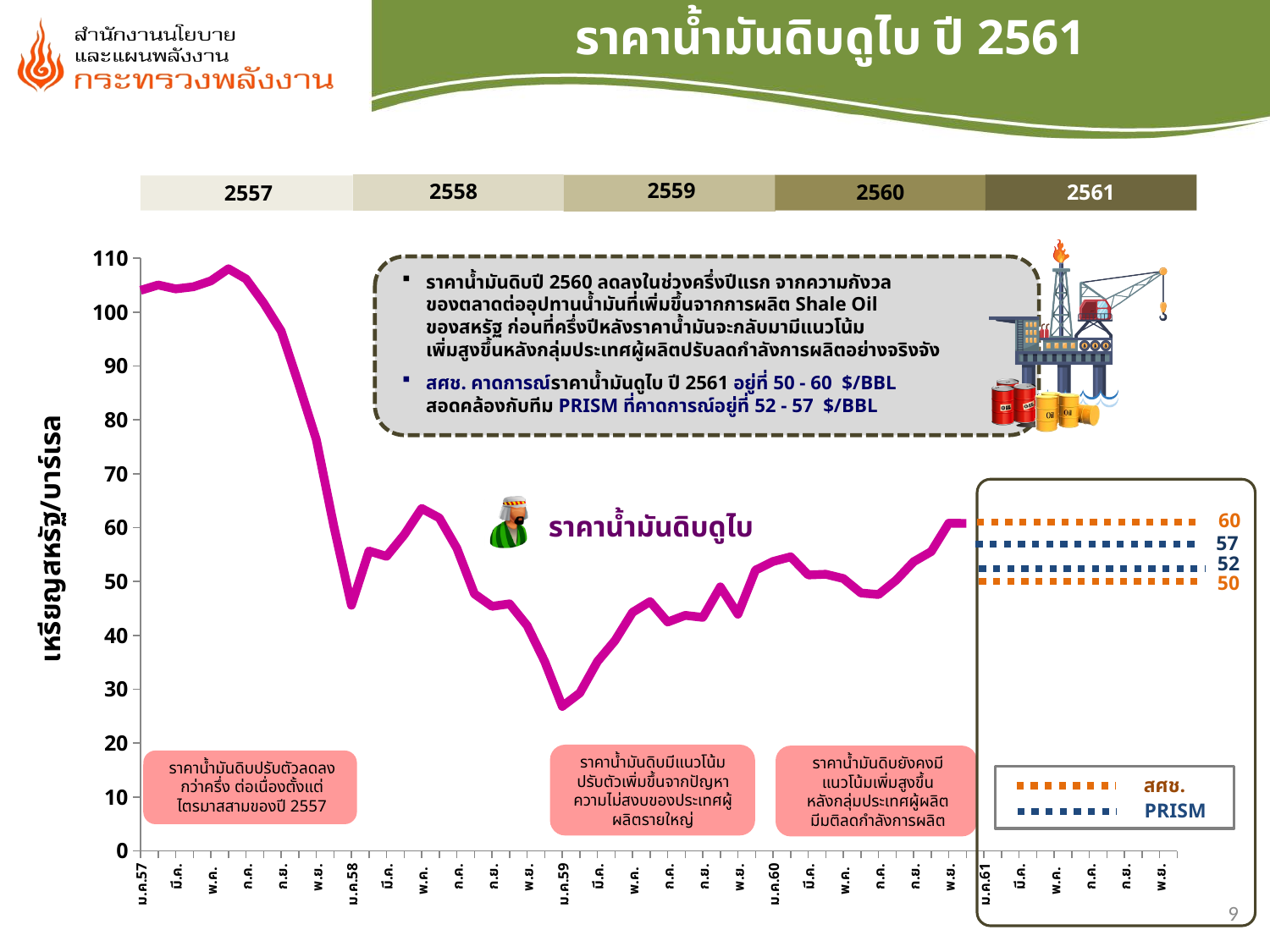
What is the lower bound of the สศช. forecast range for 2561 shown on the chart? 50 What is the upper bound of the PRISM forecast range for 2561 shown on the chart? 57 What is the upper bound of the สศช. forecast range for 2561 shown on the chart? 60 What kind of chart is used to show the Dubai crude oil price on this slide? line chart What is the difference between the upper and lower bounds of the PRISM forecast range (57 and 52)? 5 Is the Dubai crude oil price at ม.ค.59 greater or less than 40 $/BBL? less What is the difference between the upper and lower bounds of the สศช. forecast range (60 and 50)? 10 What is the lower bound of the PRISM forecast range for 2561 shown on the chart? 52 Which forecast has the higher upper bound for 2561, สศช. or PRISM? สศช. How many entries does the legend in the lower right of the chart list? 2 Is the Dubai crude oil price at ม.ค.57 greater or less than 100 $/BBL? greater Does the Dubai crude oil price rise or fall from ม.ค.57 to ม.ค.59? fall